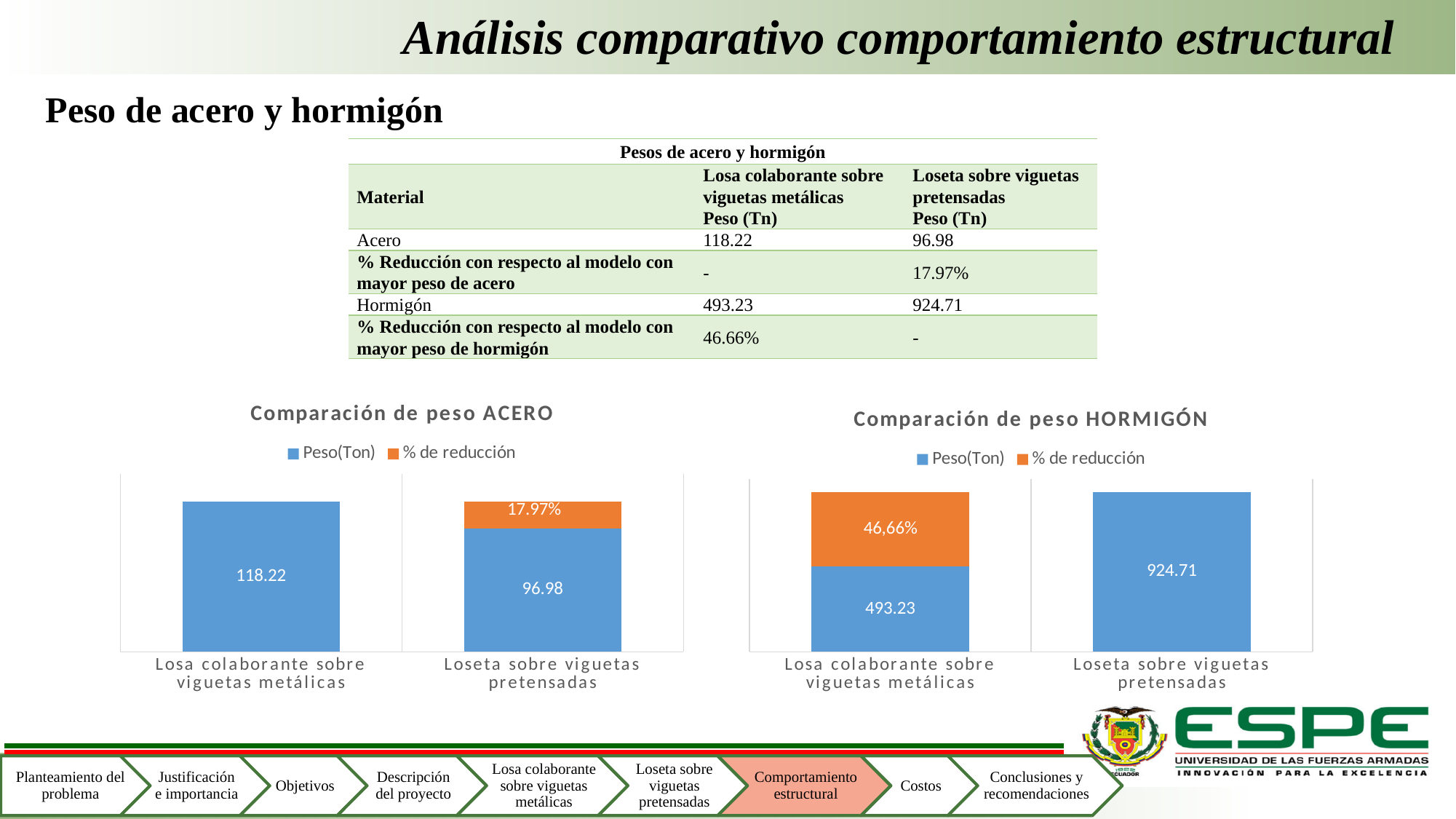
In the 'Comparación de peso HORMIGÓN' chart, what is the difference in Peso(Ton) between Loseta sobre viguetas pretensadas and Losa colaborante sobre viguetas metálicas? 431.48 In the 'Comparación de peso HORMIGÓN' chart, what is the Peso(Ton) value for Losa colaborante sobre viguetas metálicas? 493.23 In the 'Comparación de peso ACERO' chart, what is the Peso(Ton) value for Loseta sobre viguetas pretensadas? 96.98 How many series does the legend of the 'Comparación de peso HORMIGÓN' chart list? 2 In the 'Comparación de peso HORMIGÓN' chart, what is the Peso(Ton) value for Loseta sobre viguetas pretensadas? 924.71 What kind of chart is 'Comparación de peso ACERO'? Stacked bar chart In the 'Comparación de peso ACERO' chart, what % de reducción is shown for Loseta sobre viguetas pretensadas? 17.97% In the 'Comparación de peso HORMIGÓN' chart, what % de reducción is shown for Losa colaborante sobre viguetas metálicas? 46,66% In the 'Comparación de peso ACERO' chart, what is the difference in Peso(Ton) between Losa colaborante sobre viguetas metálicas and Loseta sobre viguetas pretensadas? 21.24 In the 'Comparación de peso ACERO' chart, what is the Peso(Ton) value for Losa colaborante sobre viguetas metálicas? 118.22 In the 'Comparación de peso HORMIGÓN' chart, which category has the lower Peso(Ton) value? Losa colaborante sobre viguetas metálicas In the 'Comparación de peso ACERO' chart, which category has the higher Peso(Ton) value? Losa colaborante sobre viguetas metálicas